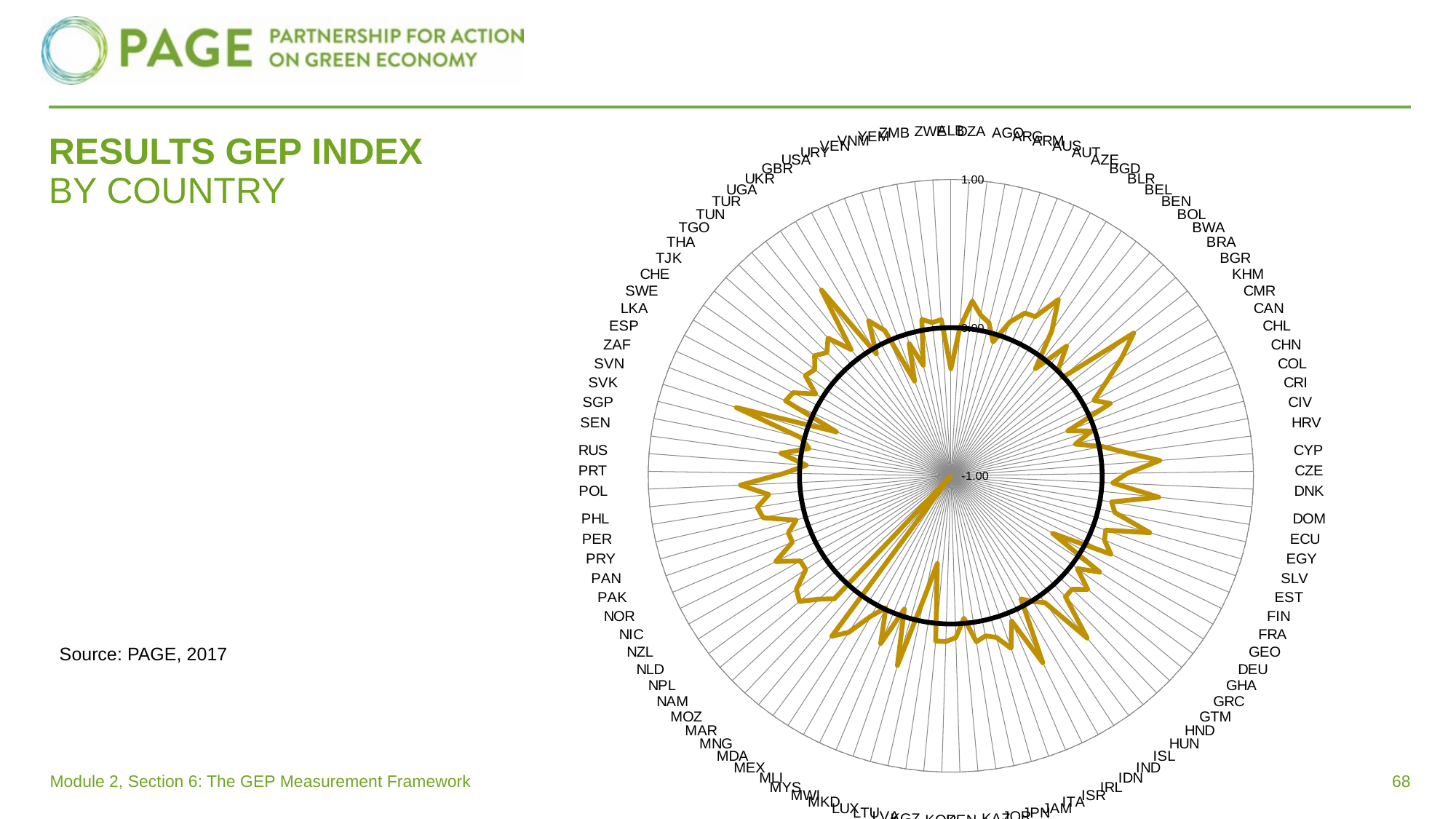
What kind of chart is shown on the slide? radar chart What is the highest value labelled on the chart's radial axis? 1.00 Is the value for CZE greater or less than 0.00? greater What is the title of the chart on the slide? RESULTS GEP INDEX BY COUNTRY Is the value for DNK greater or less than 1.00? less Is the value for SGP greater or less than 1.00? less